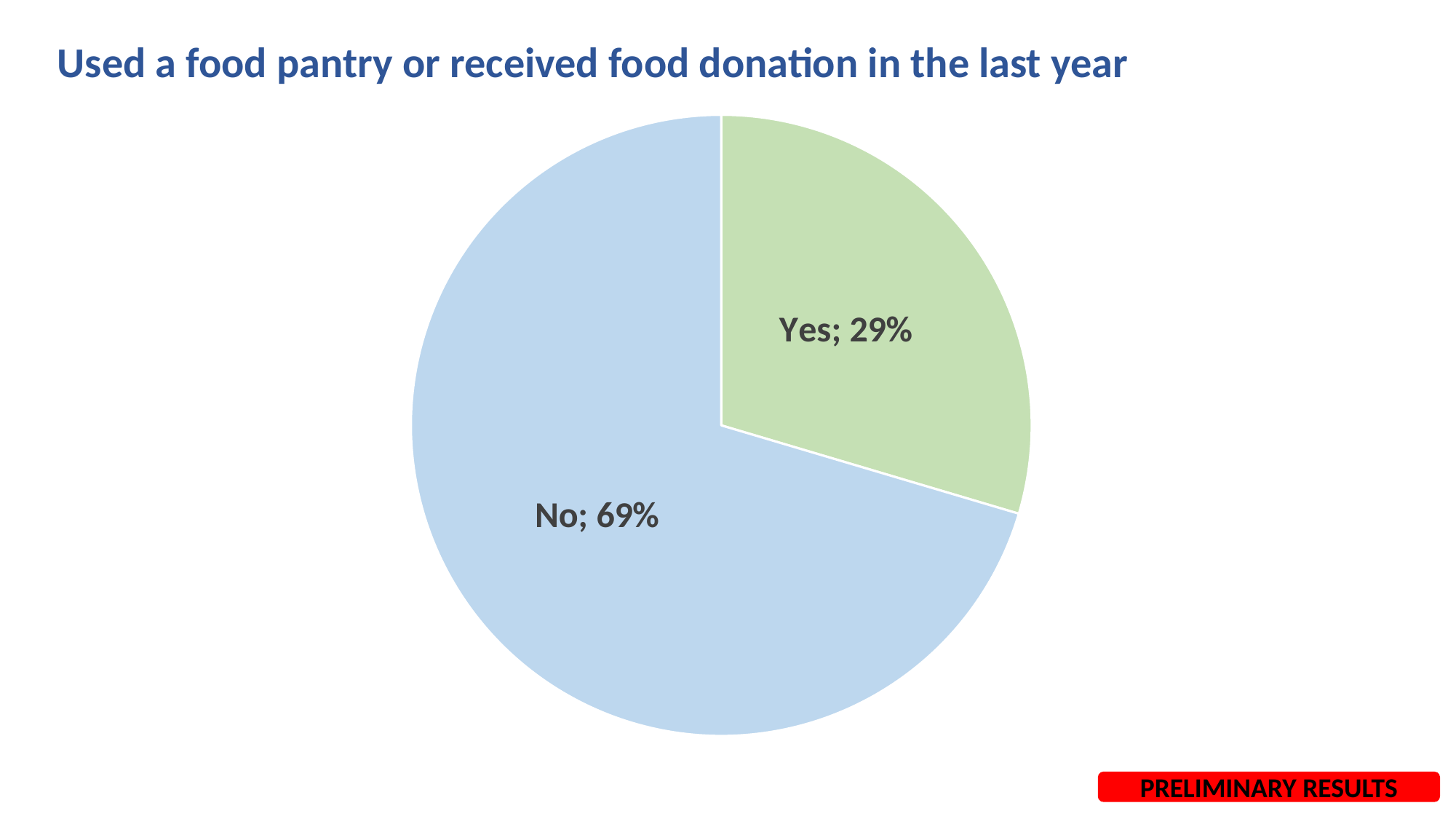
What colour is the No slice? light blue What is the difference in percentage points between the No and Yes slices? 40 What kind of chart is shown on the slide? pie chart What percentage of respondents answered No? 69% What is the title of the chart? Used a food pantry or received food donation in the last year Which slice is the largest? No Which slice is the smallest? Yes What percentage of respondents answered Yes? 29% How many slices does the pie chart have? 2 Which is larger, the Yes slice or the No slice? No What share of the pie does the Yes slice represent? 29%